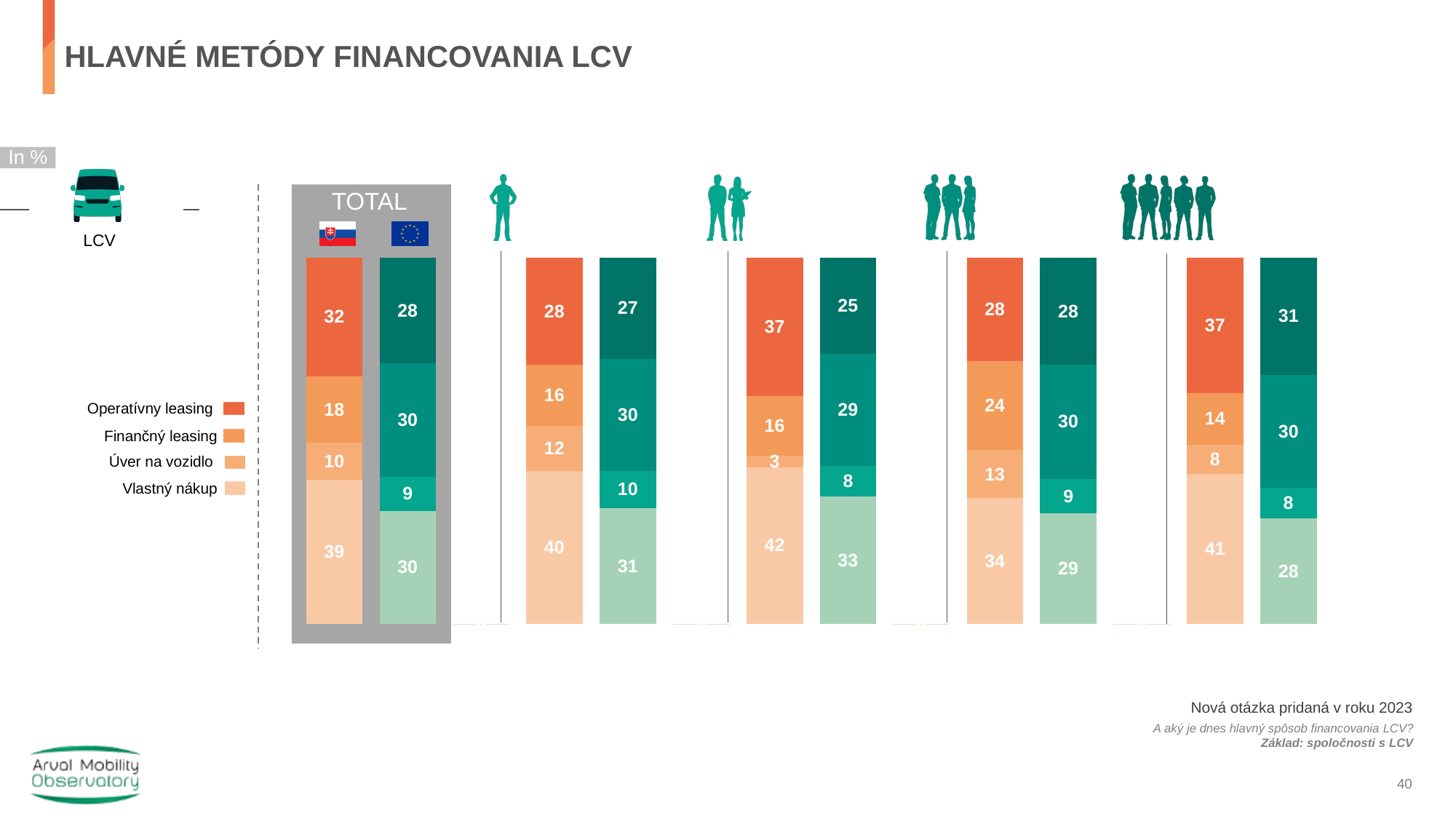
In the TOTAL group, what is the value for Vlastný nákup in the Slovak (flag) bar? 39 How many series does the legend list? 4 In the TOTAL group, what is the value for Úver na vozidlo in the EU (flag) bar? 9 In the TOTAL group, what is the difference between the Slovak and EU values for Operatívny leasing? 4 In what unit are the chart values expressed, according to the label at the top left? In % In the TOTAL group, which financing method has the smallest segment in the Slovak (flag) bar? Úver na vozidlo In the TOTAL group, what is the value for Finančný leasing in the EU (flag) bar? 30 What is the sum of the printed segment values in the Slovak (flag) TOTAL bar? 99 In the TOTAL group, what is the value for Operatívny leasing in the Slovak (flag) bar? 32 In the TOTAL group, which bar has the larger value for Vlastný nákup, the Slovak bar or the EU bar? Slovak bar In the TOTAL group, which financing method has the largest segment in the Slovak (flag) bar? Vlastný nákup What type of chart is shown on the slide? Stacked bar chart